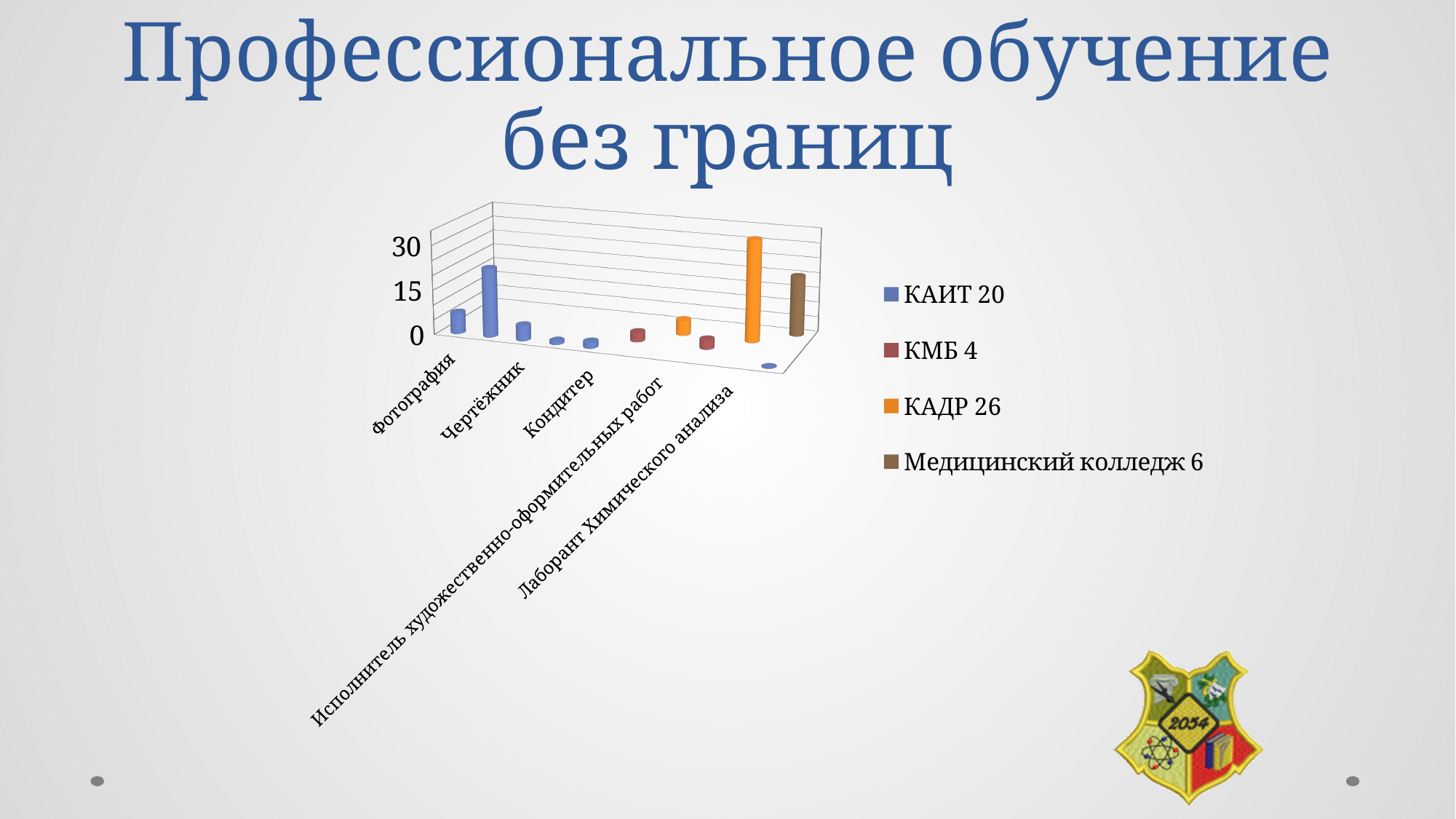
Which series has the tallest bar in the chart? КАДР 26 Is the КАИТ 20 value for Фотография greater or less than 15? less Is the КАИТ 20 value for Кондитер greater or less than 15? less Which series is shown in orange in the chart legend? КАДР 26 What is the highest value shown on the vertical axis of the chart? 30 How many series does the chart legend list? 4 Which is larger for the КАИТ 20 series: the value for Чертёжник or the value for Фотография? Фотография Which category has the tallest bar in the chart? Лаборант Химического анализа What kind of chart is shown on the slide? bar chart Is the КАДР 26 value for Лаборант Химического анализа greater or less than 15? greater